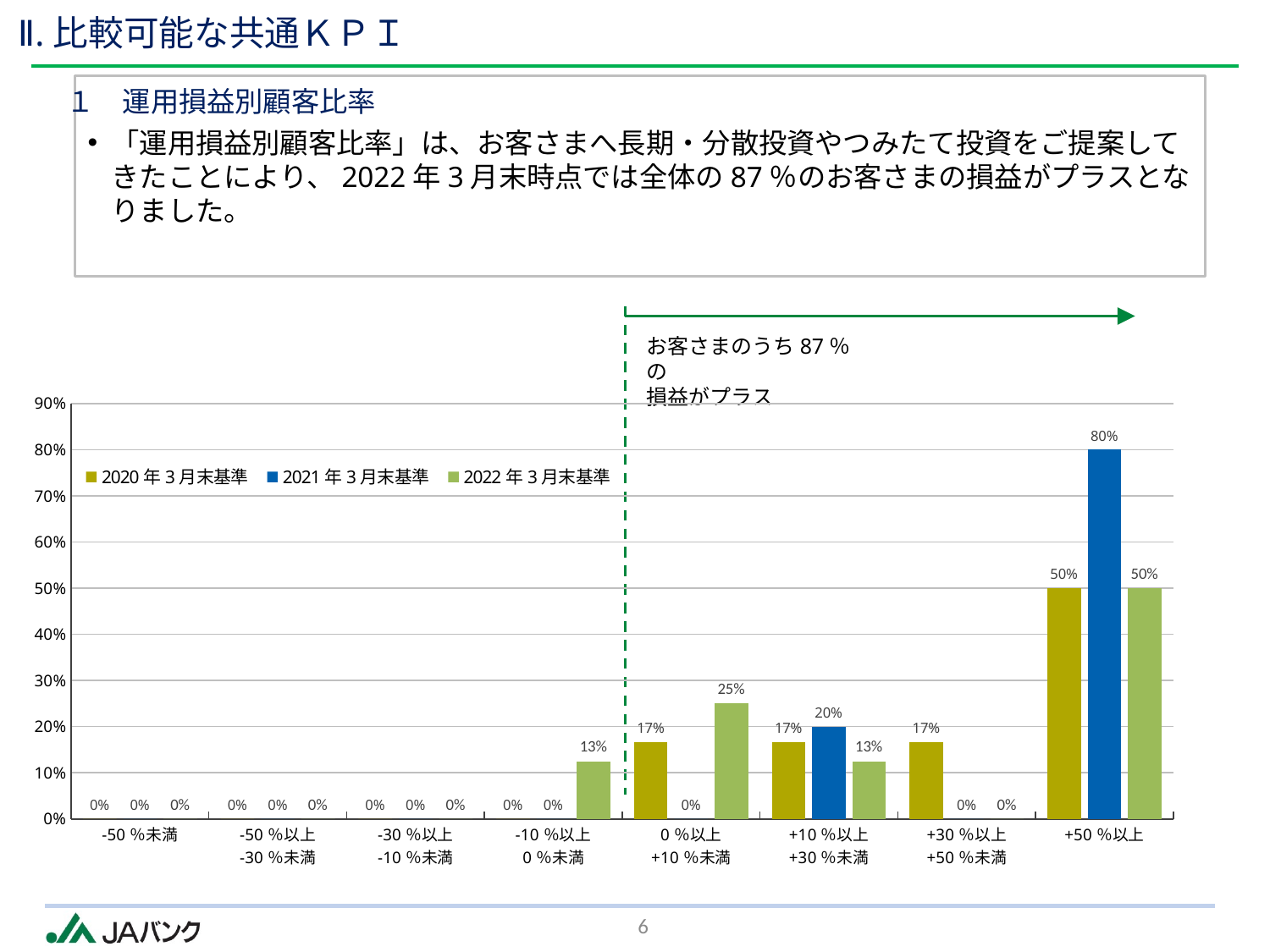
What is the value for 2021年3月末基準 in the 0%以上+10%未満 category? 0% How many series does the legend list? 3 In the +10%以上+30%未満 category, which is larger: 2021年3月末基準 or 2022年3月末基準? 2021年3月末基準 How many categories are shown on the x axis? 8 What is the value for 2022年3月末基準 in the 0%以上+10%未満 category? 25% What type of chart is shown on the slide? bar chart Which category has the highest value for 2021年3月末基準? +50%以上 Is the value for 2021年3月末基準 in the +50%以上 category greater or less than 70%? greater What is the value for 2020年3月末基準 in the +30%以上+50%未満 category? 17% What is the difference between the 2021年3月末基準 and 2020年3月末基準 values in the +50%以上 category? 30% What is the value for 2021年3月末基準 in the +50%以上 category? 80% What is the value for 2022年3月末基準 in the -10%以上0%未満 category? 13%